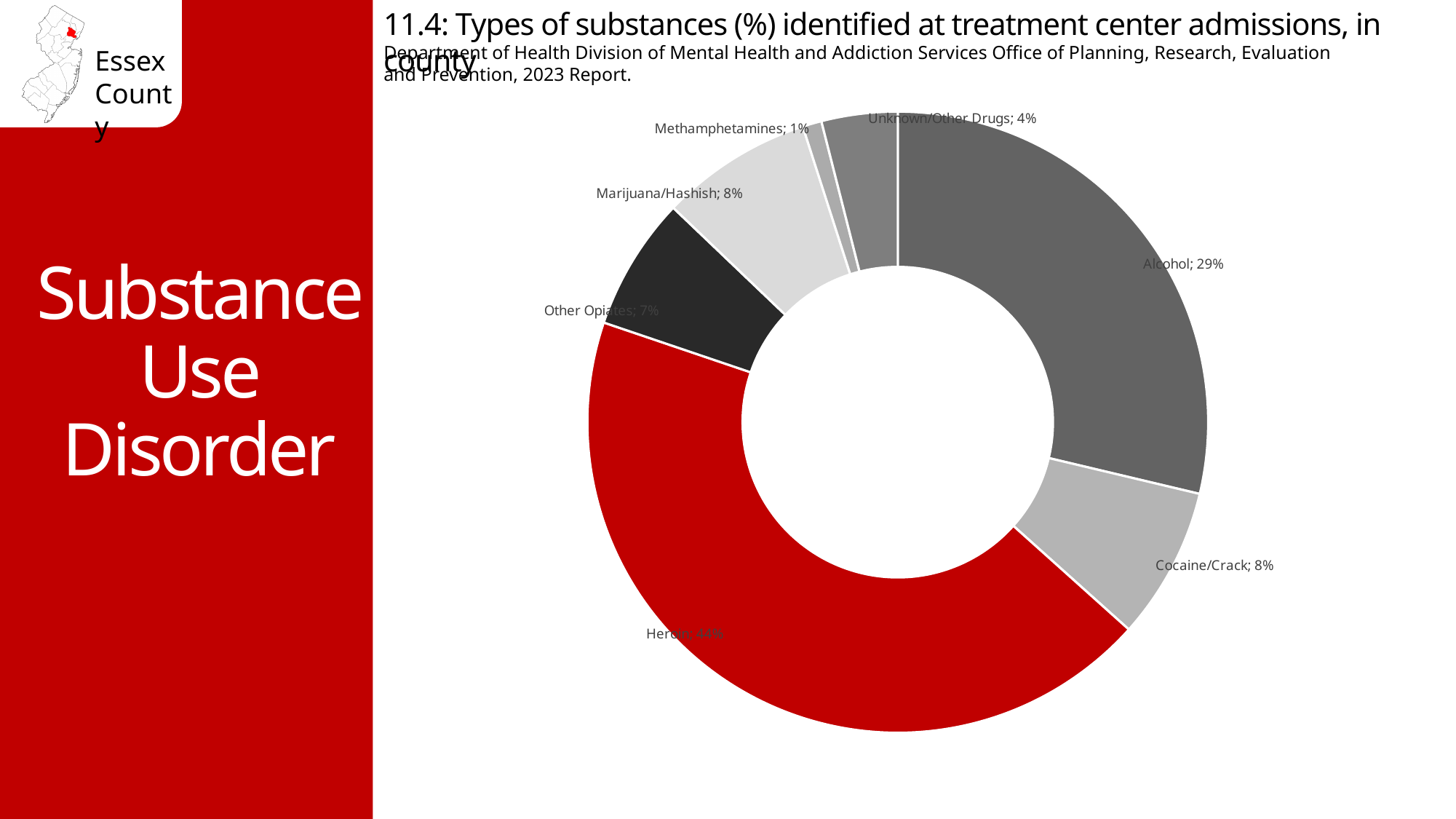
What percentage is shown for Alcohol? 29% What percentage is shown for Other Opiates? 7% What colour is the Heroin slice? Red What percentage of treatment center admissions identified Heroin? 44% What kind of chart is shown on the slide? Doughnut (pie) chart Which is larger, the share for Alcohol or for Cocaine/Crack? Alcohol What is the combined percentage for Heroin and Alcohol? 73% Which substance has the largest share of admissions? Heroin How many percentage points higher is Heroin than Alcohol? 15 What percentage is shown for Unknown/Other Drugs? 4% Which is larger, the share for Marijuana/Hashish or for Other Opiates? Marijuana/Hashish What percentage is shown for Methamphetamines? 1%